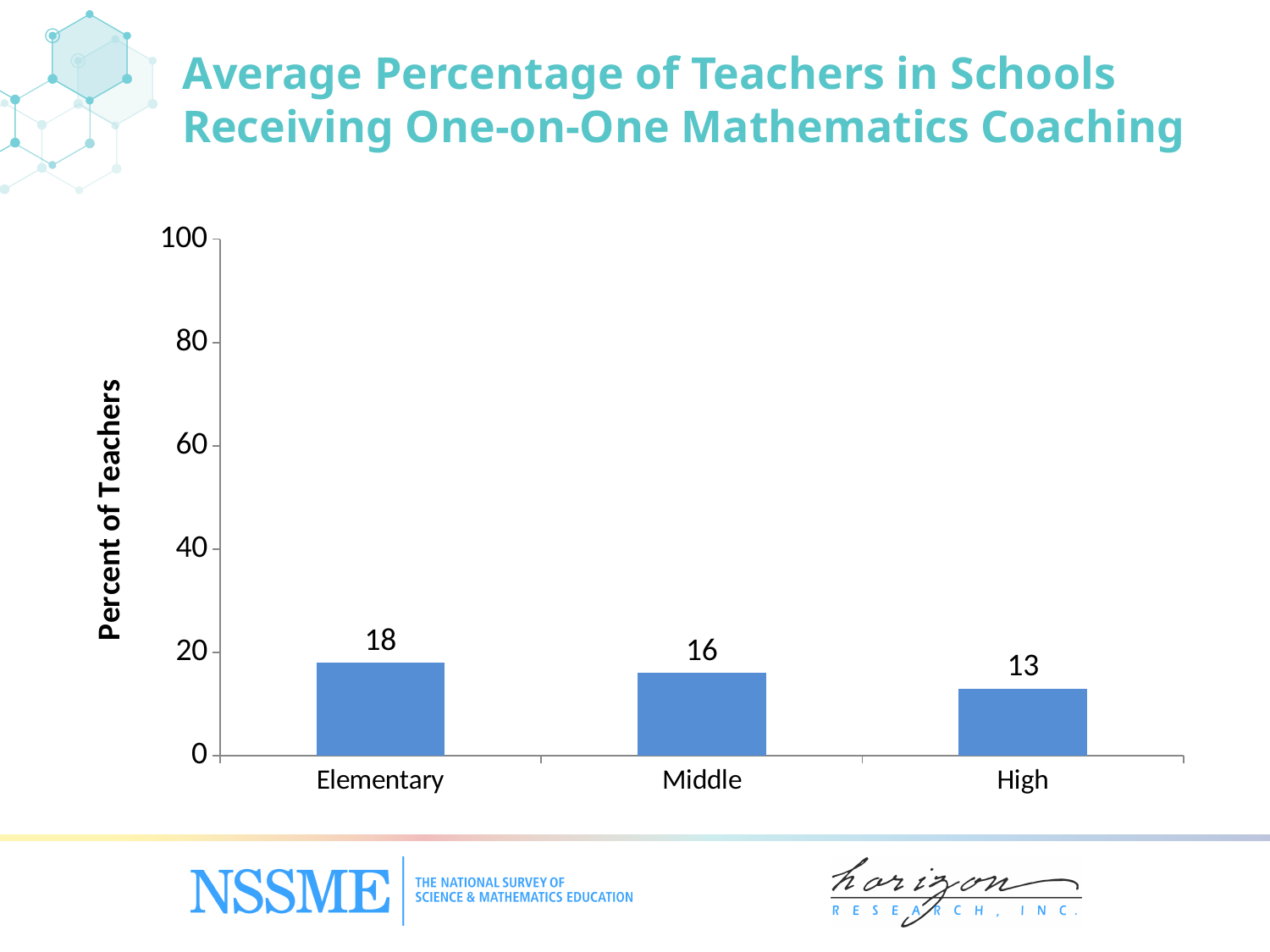
How many school levels are shown on the chart? 3 What is the difference between the values for Middle and High? 3 Which school level has the highest percentage of teachers receiving one-on-one mathematics coaching? Elementary What kind of chart is shown on the slide? bar chart Which is larger, the value for Elementary or the value for Middle? Elementary What is the difference between the values for Elementary and High? 5 What is the value for High? 13 Is the value for Elementary greater or less than 20? less Do the values rise or fall from Elementary to High? fall Which school level has the lowest percentage of teachers receiving one-on-one mathematics coaching? High What is the value for Elementary? 18 What is the value for Middle? 16